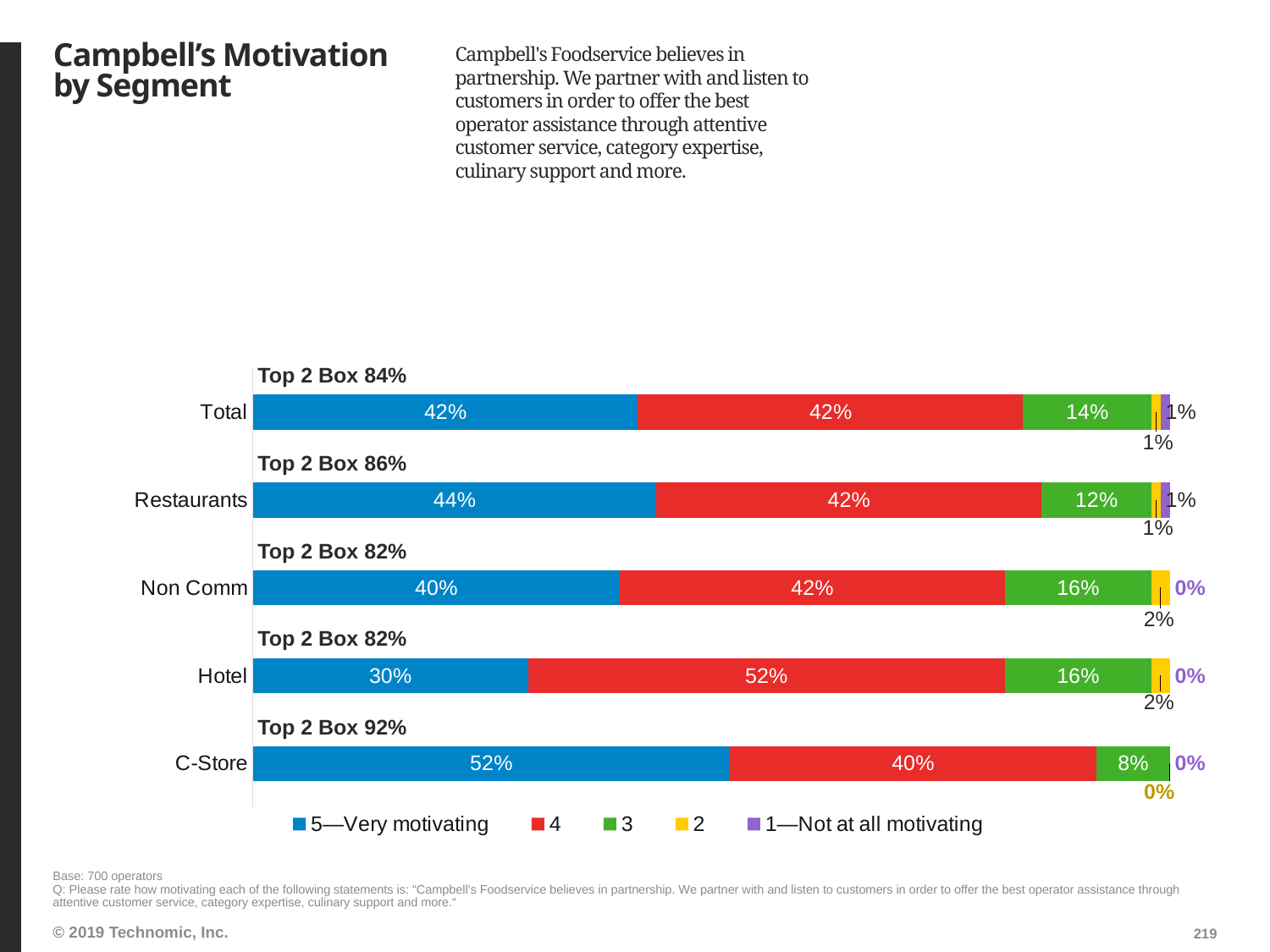
Which is larger: the '3' rating for Total or the '3' rating for C-Store? Total What type of chart is shown on the slide? Stacked bar chart What is the value for the '4' rating for Hotel? 52% Which segment has the highest Top 2 Box value? C-Store Which segment has the lowest share of 5—Very motivating ratings? Hotel What percentage of C-Store operators rated the statement 5—Very motivating? 52% What percentage of Non Comm operators gave a rating of 3? 16% How many segments are shown on the chart? 5 Which segment has the highest share of 5—Very motivating ratings? C-Store What is the Top 2 Box value for Restaurants? 86% How many series does the legend list? 5 What is the difference between the 5—Very motivating values for C-Store and Hotel? 22 percentage points